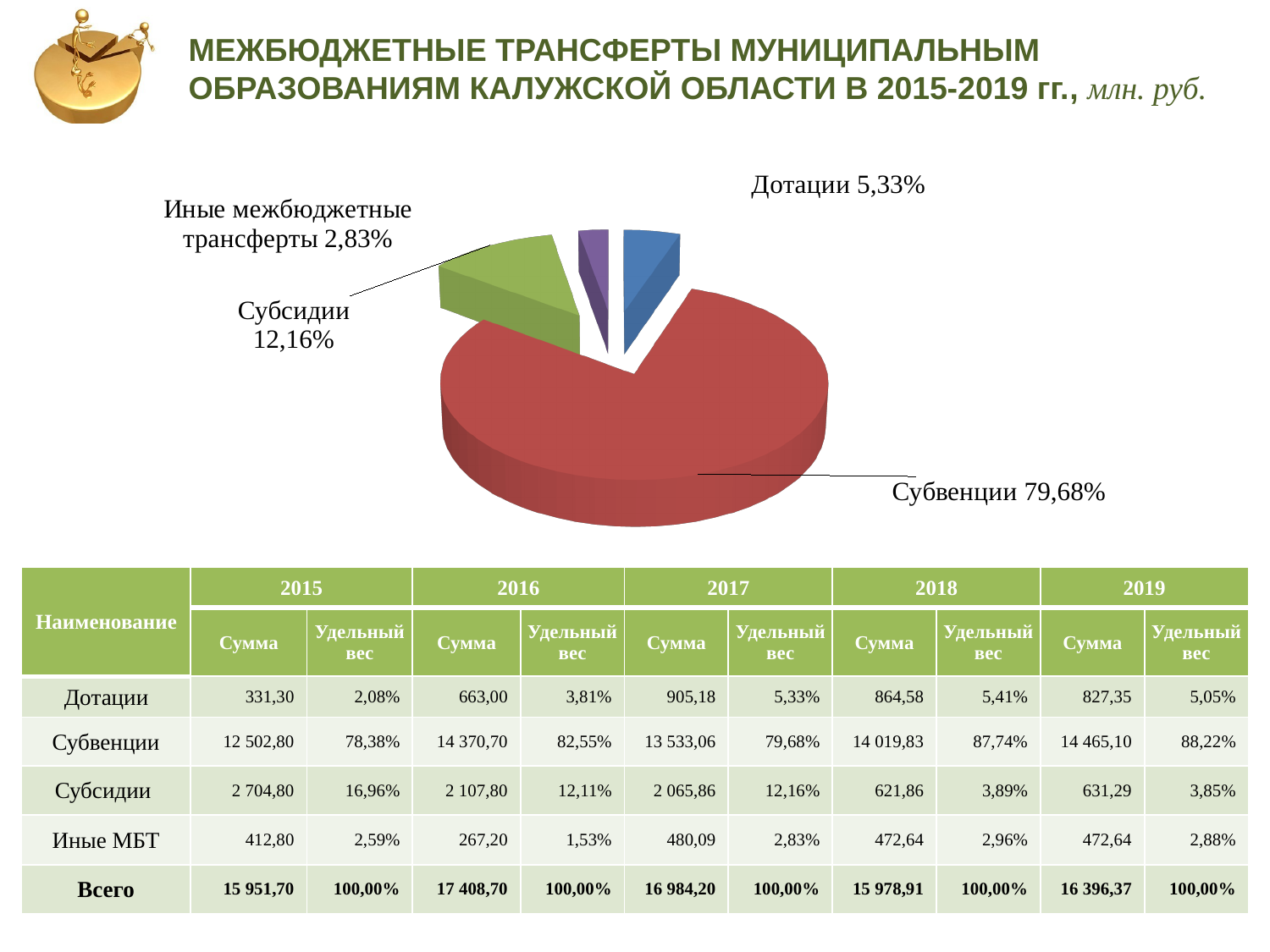
Which slice of the pie chart is the largest? Субвенции How many slices does the pie chart have? 4 Is the share for Субвенции greater or less than 50%? greater What share of the pie does Дотации hold? 5,33% What share of the pie does Субвенции hold? 79,68% What share of the pie does Иные межбюджетные трансферты hold? 2,83% What colour is the Субвенции slice in the pie chart? Red Which is larger in the pie chart, Субсидии or Дотации? Субсидии What is the difference in percentage points between the Субсидии and Дотации slices? 6,83 Which slice of the pie chart is the smallest? Иные межбюджетные трансферты What kind of chart is shown on the slide? Pie chart